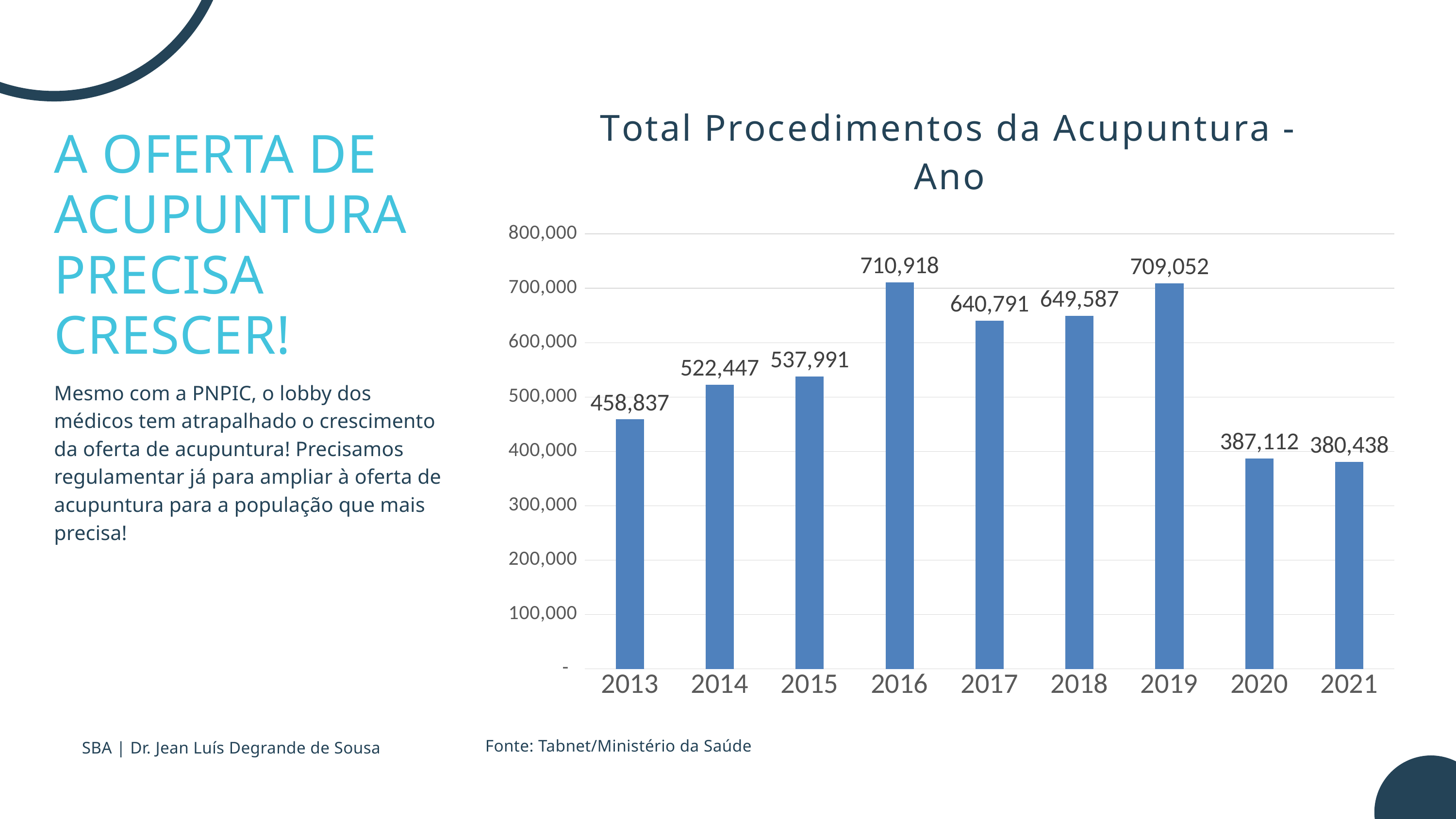
What is the difference between the values for 2016 and 2013? 252,081 What is the value for 2016 in the chart? 710,918 What is the title of the chart? Total Procedimentos da Acupuntura - Ano How many years are shown on the x axis of the chart? 9 What is the value for 2013 in the chart? 458,837 Which is larger, the value for 2014 or the value for 2015? 2015 Which year has the highest value in the chart? 2016 What kind of chart is shown on the slide? bar chart Which year has the lowest value in the chart? 2021 Is the value for 2017 greater or less than 600,000? greater What is the value for 2020 in the chart? 387,112 What is the difference between the values for 2019 and 2020? 321,940